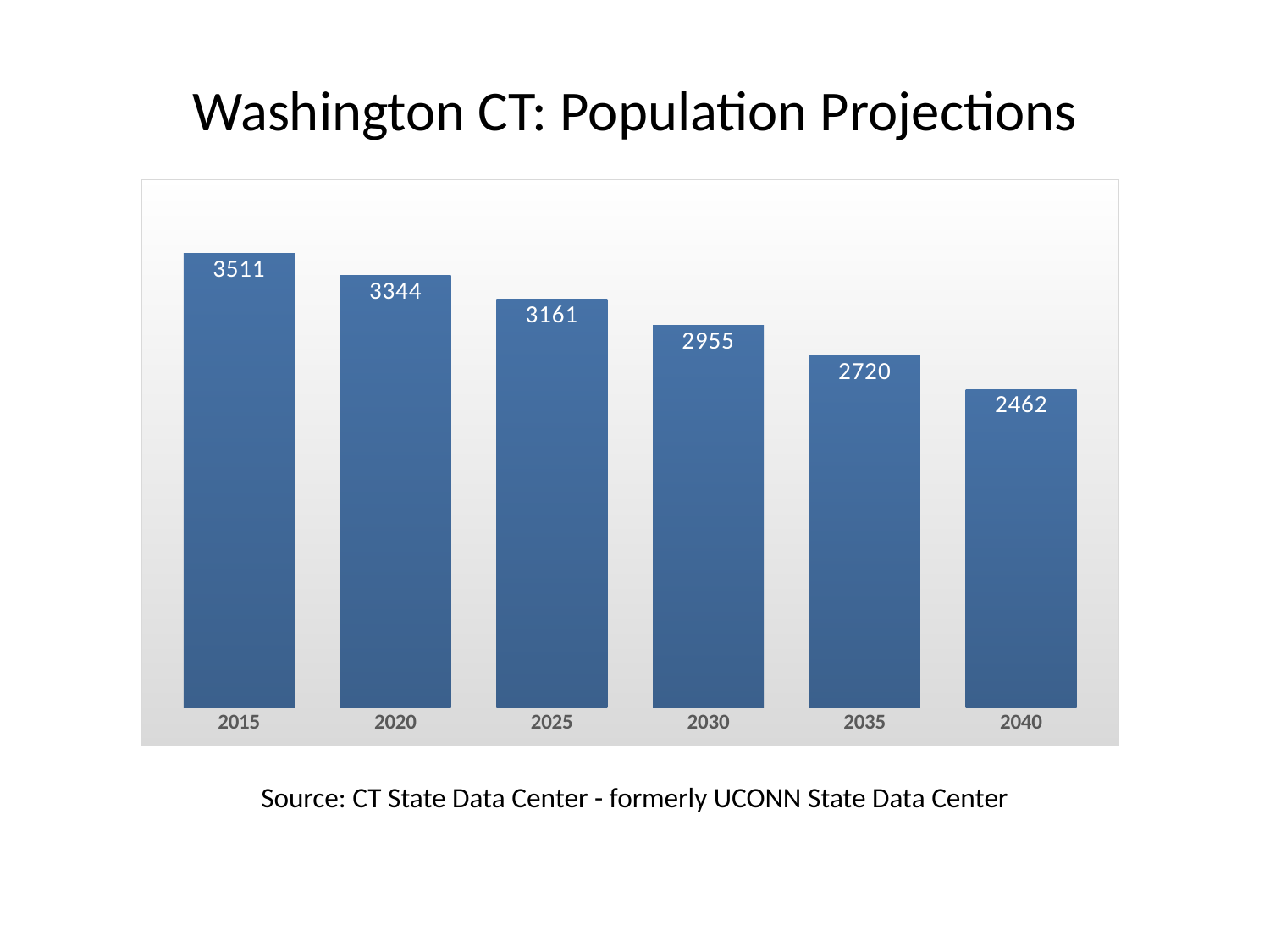
What is the title of the slide? Washington CT: Population Projections Which year has the highest projected population? 2015 How many years are shown on the chart? 6 What kind of chart is shown on the slide? Bar chart What is the difference between the projected populations for 2015 and 2040? 1049 What is the projected population for 2030? 2955 Which year has the lowest projected population? 2040 Do the projected population values rise or fall from 2015 to 2040? Fall What is the difference between the projected populations for 2020 and 2025? 183 What is the projected population for 2015? 3511 Which year has a larger projected population, 2025 or 2035? 2025 What is the projected population for 2040? 2462